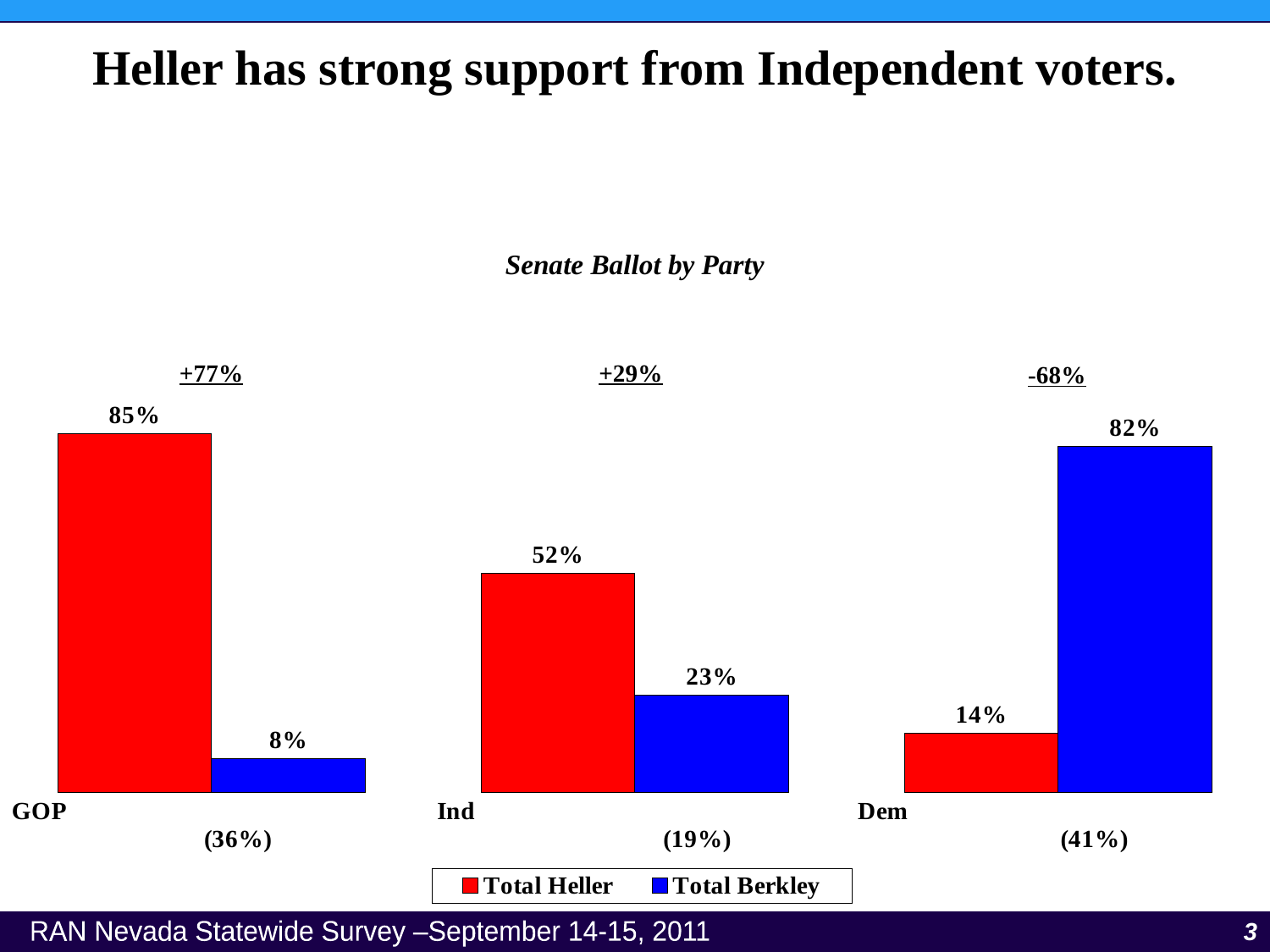
What is the Total Berkley value for Dem voters? 82% What is the title of the chart? Senate Ballot by Party What kind of chart is shown on the slide? Bar chart Which party group has the lowest Total Berkley value? GOP Among Dem voters, which is larger: Total Heller or Total Berkley? Total Berkley What is the Total Heller value for Dem voters? 14% Which party group has the highest Total Heller value? GOP What is the Total Berkley value for Ind voters? 23% What is the difference between Total Heller and Total Berkley among Ind voters? 29% What is the Total Heller value for GOP voters? 85% How many party groups are shown on the x axis? 3 How many series does the legend list? 2